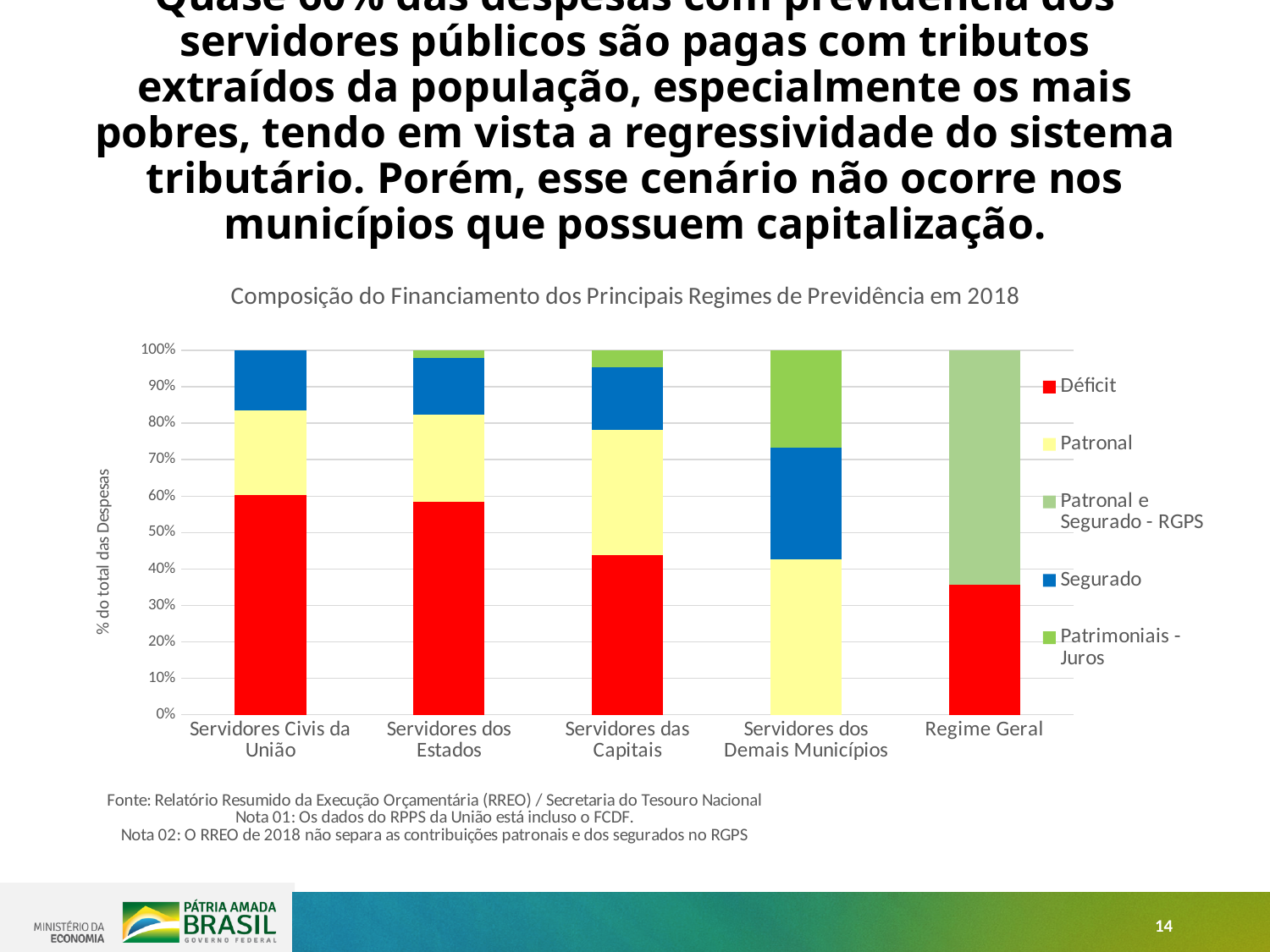
How many series does the chart legend list? 5 Which category has no Déficit segment in its bar? Servidores dos Demais Municípios How many categories are shown on the x axis of the chart? 5 Which has a larger Déficit share: Servidores Civis da União or Servidores das Capitais? Servidores Civis da União What is the label of the y axis? % do total das Despesas Is the Déficit share for Servidores Civis da União greater or less than 50%? greater What kind of chart is shown on the slide? Stacked bar chart What is the title of the chart? Composição do Financiamento dos Principais Regimes de Previdência em 2018 Which has a larger Segurado share: Servidores dos Demais Municípios or Servidores Civis da União? Servidores dos Demais Municípios What is the total height of the stacked bar for Servidores dos Estados? 100% Is the Déficit share for Servidores das Capitais greater or less than 50%? less Is the Déficit share for Regime Geral greater or less than 50%? less